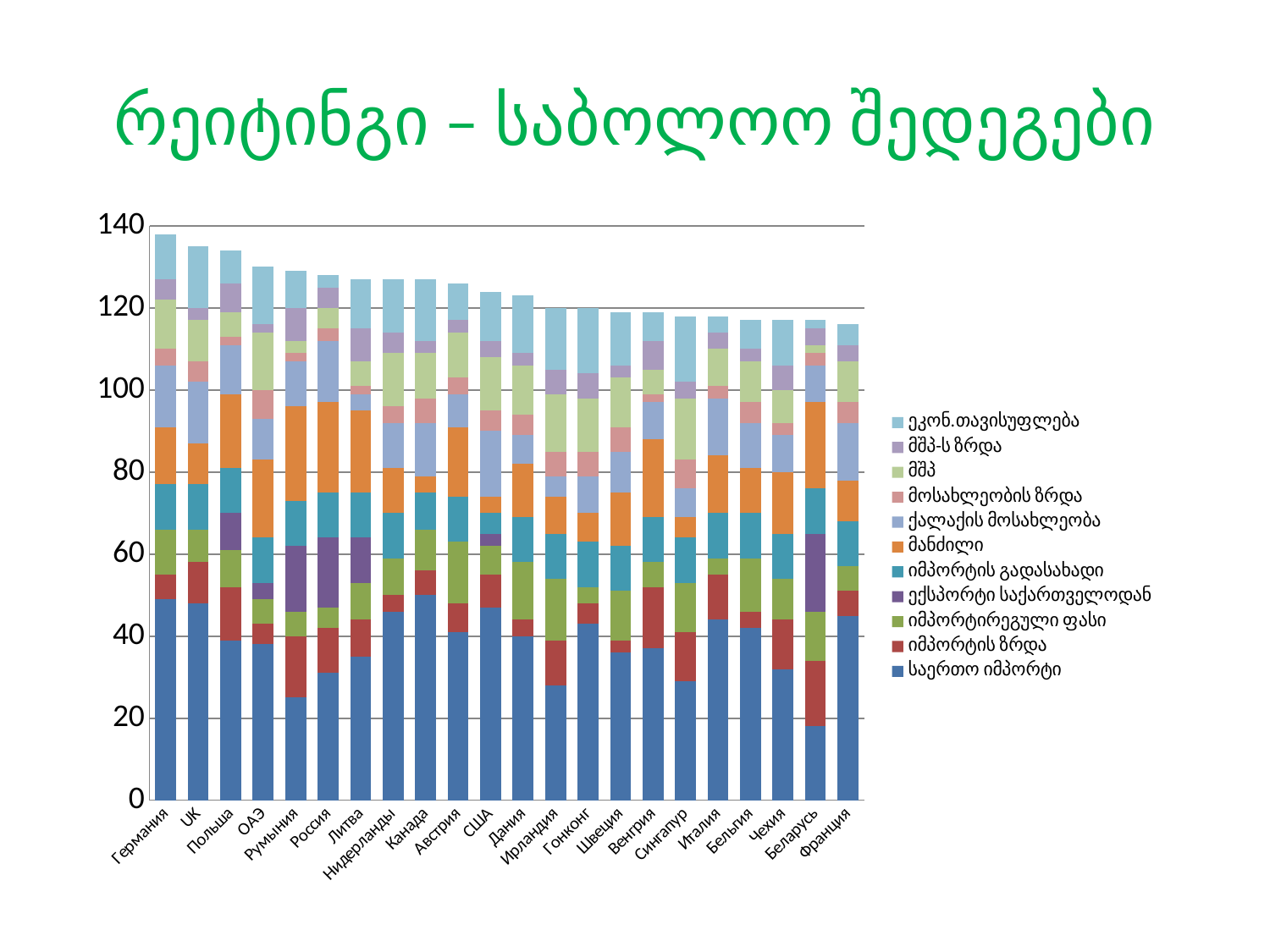
How many countries are shown along the x axis of the chart? 22 Which country has the highest total stacked bar? Германия Which series is listed first (at the top) in the chart's legend? ეკონ.თავისუფლება Is the total stacked value for Франция greater or less than 120? less Is the total stacked value for Германия greater or less than 120? greater Which has the larger total stacked bar, Германия or Франция? Германия How many series does the chart's legend list? 11 Is the bottom segment (საერთო იმპორტი) for Румыния greater or less than 20? greater What kind of chart is shown on the slide? stacked bar chart Which country has the lowest total stacked bar? Франция What is the title of the slide above the chart? რეიტინგი – საბოლოო შედეგები Do the total bar heights rise or fall moving from left to right along the x axis? fall